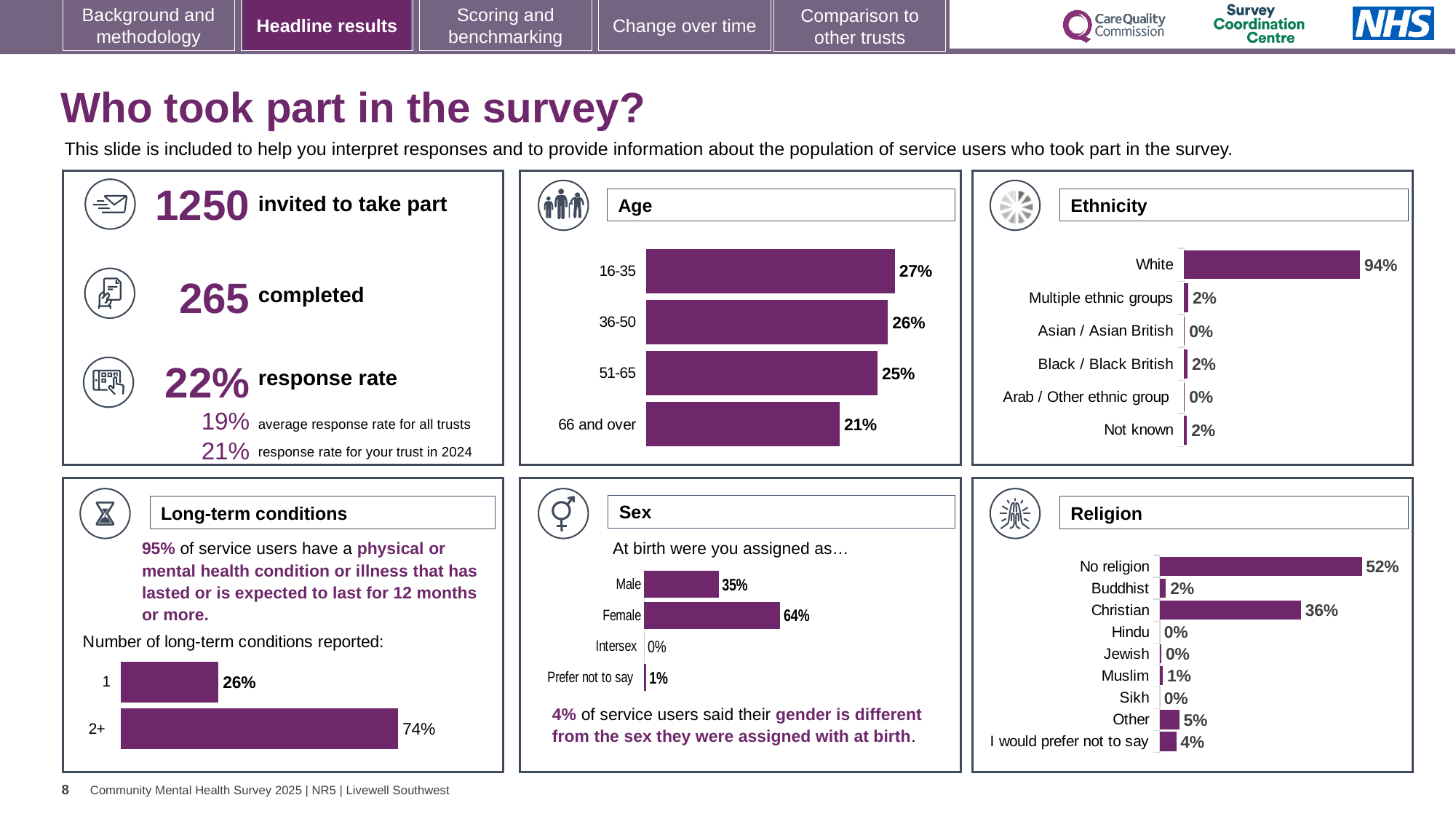
In the Age chart, what percentage of respondents were aged 16-35? 27% In the Age chart, what is the difference between the 16-35 and 66 and over percentages? 6% In the Long-term conditions chart, what percentage of respondents reported 2+ long-term conditions? 74% In the Age chart, which age group has the lowest percentage? 66 and over What type of chart is used in the Age panel? Bar chart In the Sex chart, which is larger, Male or Female? Female How many ethnicity categories are shown in the Ethnicity chart? 6 In the Religion chart, what percentage of respondents were Christian? 36% In the Ethnicity chart, what percentage of respondents were White? 94% In the Religion chart, what is the difference between No religion and Christian? 16% In the Religion chart, which category has the highest percentage? No religion In the Sex chart, what percentage of respondents were assigned Female at birth? 64%